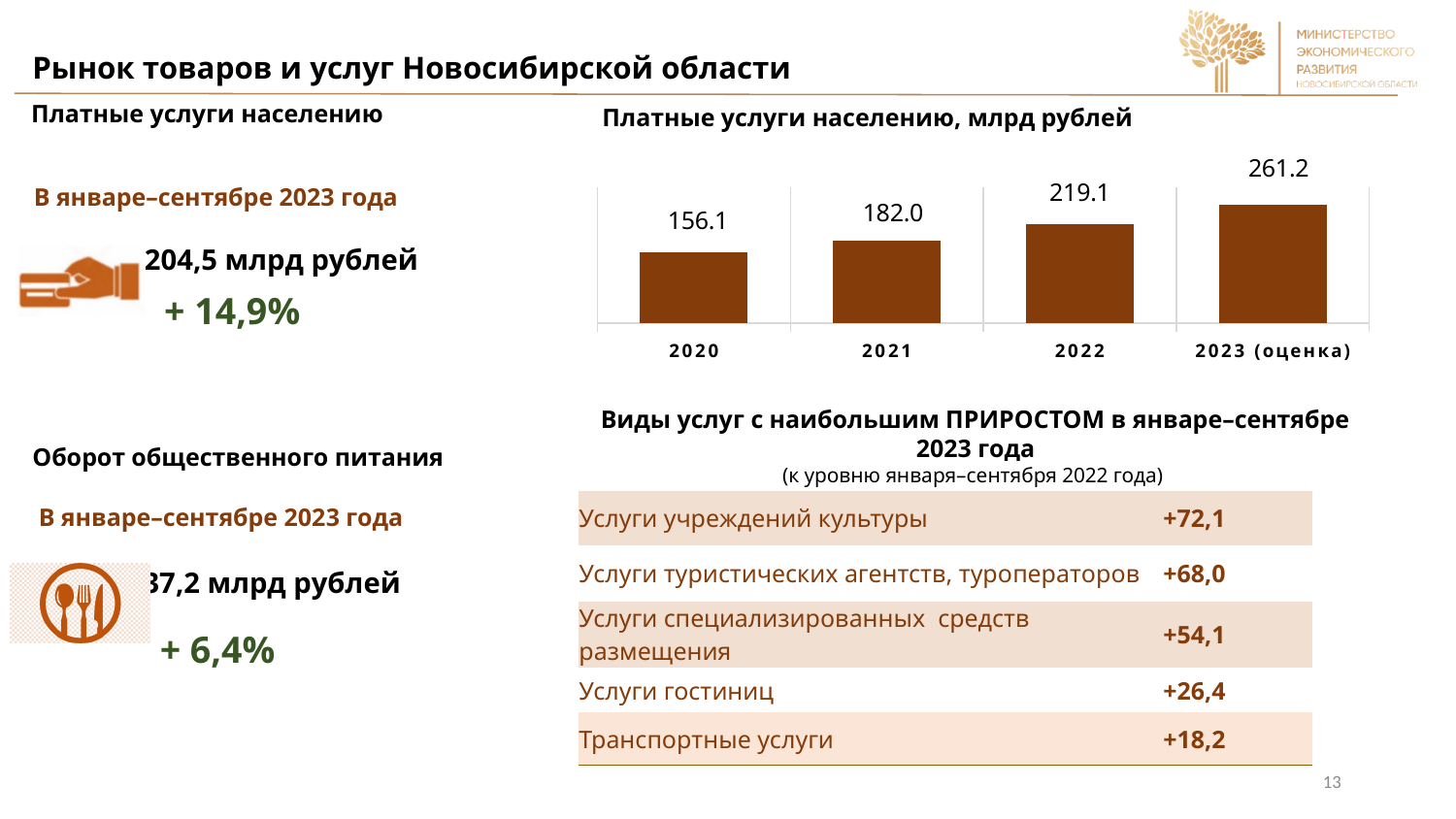
Which year has the lowest value in the chart 'Платные услуги населению, млрд рублей'? 2020 Which year has the highest value in the chart 'Платные услуги населению, млрд рублей'? 2023 (оценка) Do the values in the chart 'Платные услуги населению, млрд рублей' rise or fall from 2020 to 2023 (оценка)? rise What is the value for 2022 in the chart 'Платные услуги населению, млрд рублей'? 219.1 In the chart 'Платные услуги населению, млрд рублей', what is the difference between the values for 2021 and 2020? 25.9 In the chart 'Платные услуги населению, млрд рублей', what is the difference between the values for 2023 (оценка) and 2022? 42.1 What is the value for 2020 in the chart 'Платные услуги населению, млрд рублей'? 156.1 What type of chart is 'Платные услуги населению, млрд рублей'? bar chart What is the value for 2023 (оценка) in the chart 'Платные услуги населению, млрд рублей'? 261.2 How many bars are shown in the chart 'Платные услуги населению, млрд рублей'? 4 In the chart 'Платные услуги населению, млрд рублей', which is larger: the value for 2021 or the value for 2022? 2022 What is the value for 2021 in the chart 'Платные услуги населению, млрд рублей'? 182.0